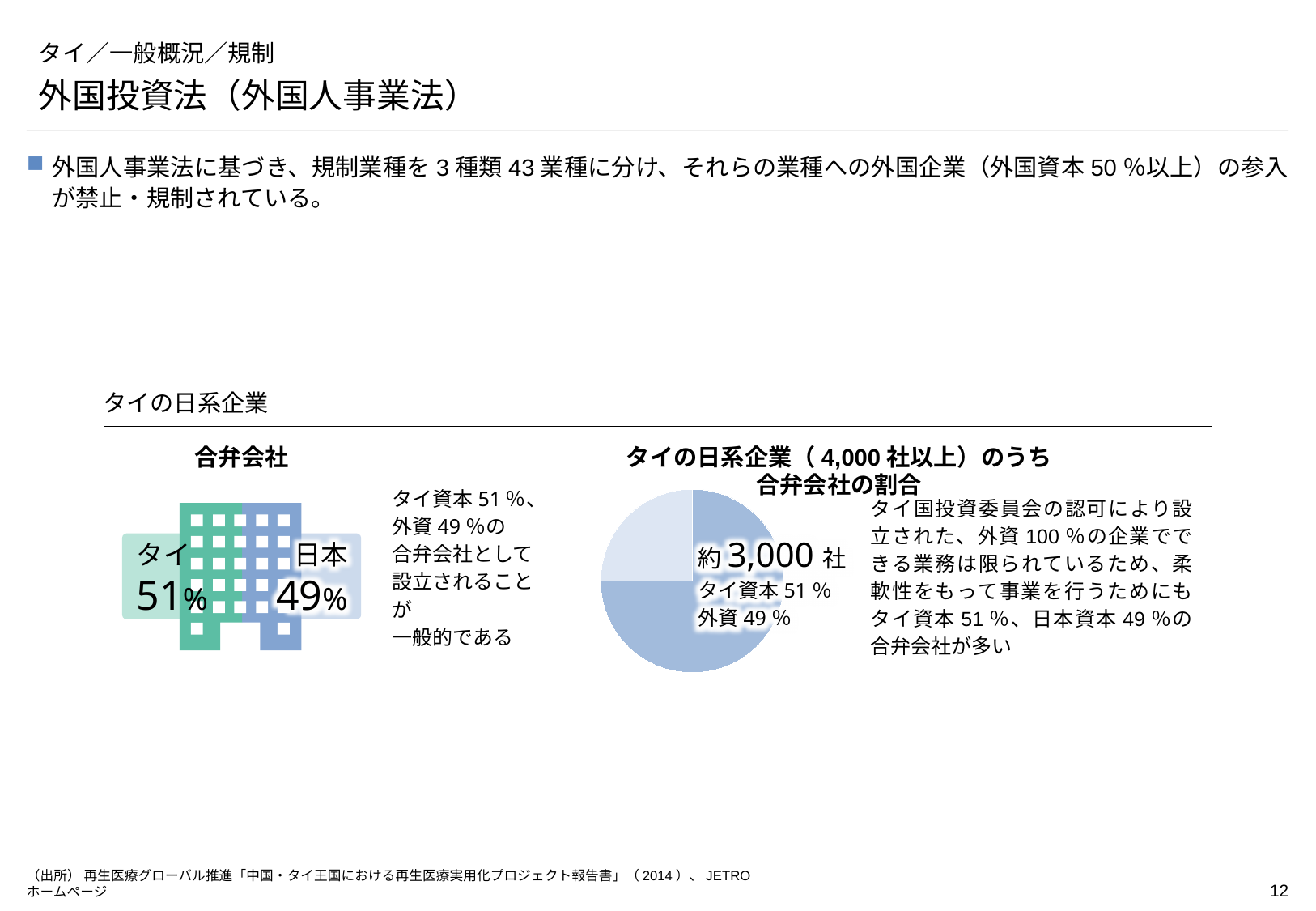
「タイの日系企業（4,000社以上）のうち合弁会社の割合」のグラフはどの種類のグラフですか？ 円グラフ 「タイの日系企業（4,000社以上）のうち合弁会社の割合」の円グラフのタイトルによると、タイの日系企業は何社以上ですか？ 4,000社以上 「タイの日系企業（4,000社以上）のうち合弁会社の割合」の円グラフはいくつの部分に分かれていますか？ 2 「タイの日系企業（4,000社以上）のうち合弁会社の割合」の円グラフで、小さい方の部分は全体の半分より大きいですか、小さいですか？ 小さい 「タイの日系企業（4,000社以上）のうち合弁会社の割合」の円グラフで、「約3,000社」と書かれた部分は全体の半分より大きいですか、小さいですか？ 大きい 「タイの日系企業（4,000社以上）のうち合弁会社の割合」の円グラフで、大きい方の部分に付いているラベルは何ですか？ 約3,000社 「タイの日系企業（4,000社以上）のうち合弁会社の割合」の円グラフの「約3,000社」のラベルの下に書かれている資本構成は何ですか？ タイ資本51%、外資49% 「タイの日系企業（4,000社以上）のうち合弁会社の割合」の円グラフで、濃い青の部分と薄い青の部分ではどちらが大きいですか？ 濃い青の部分